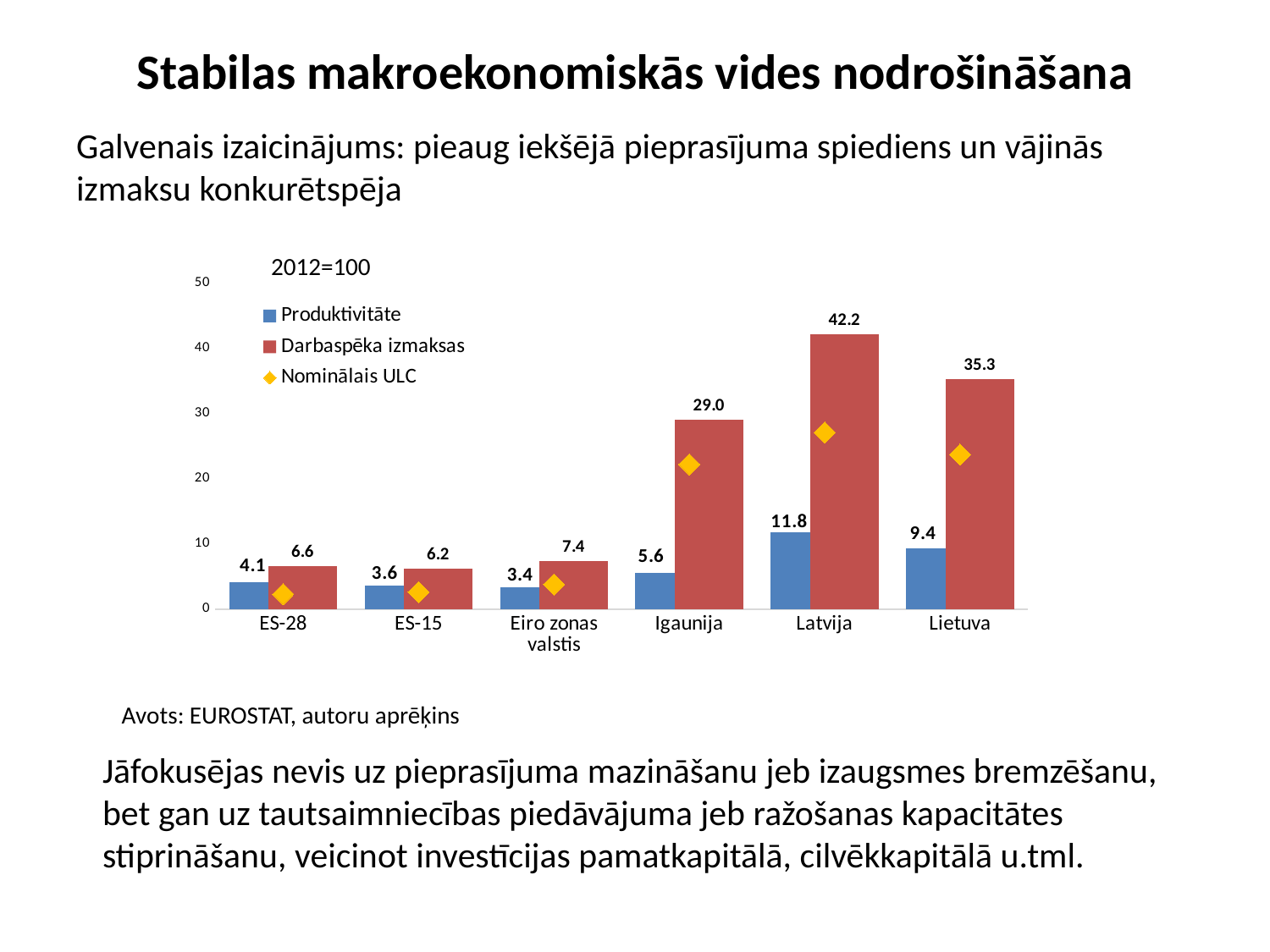
What is the difference between Darbaspēka izmaksas and Produktivitāte for Lietuva? 25.9 Is the Nominālais ULC value for ES-28 greater or less than 10? less How many categories are shown on the x axis? 6 How many series does the legend list? 3 Which category has the highest Darbaspēka izmaksas value? Latvija Which is larger: Produktivitāte for Latvija or Produktivitāte for Lietuva? Latvija What is the value of Darbaspēka izmaksas for Eiro zonas valstis? 7.4 Is the Nominālais ULC value for Latvija greater or less than 20? greater What is the value of Darbaspēka izmaksas for Latvija? 42.2 What kind of chart is shown on the slide? Combination chart: bars (Produktivitāte, Darbaspēka izmaksas) with diamond markers for Nominālais ULC What is the value of Produktivitāte for Igaunija? 5.6 Which category has the lowest Produktivitāte value? Eiro zonas valstis